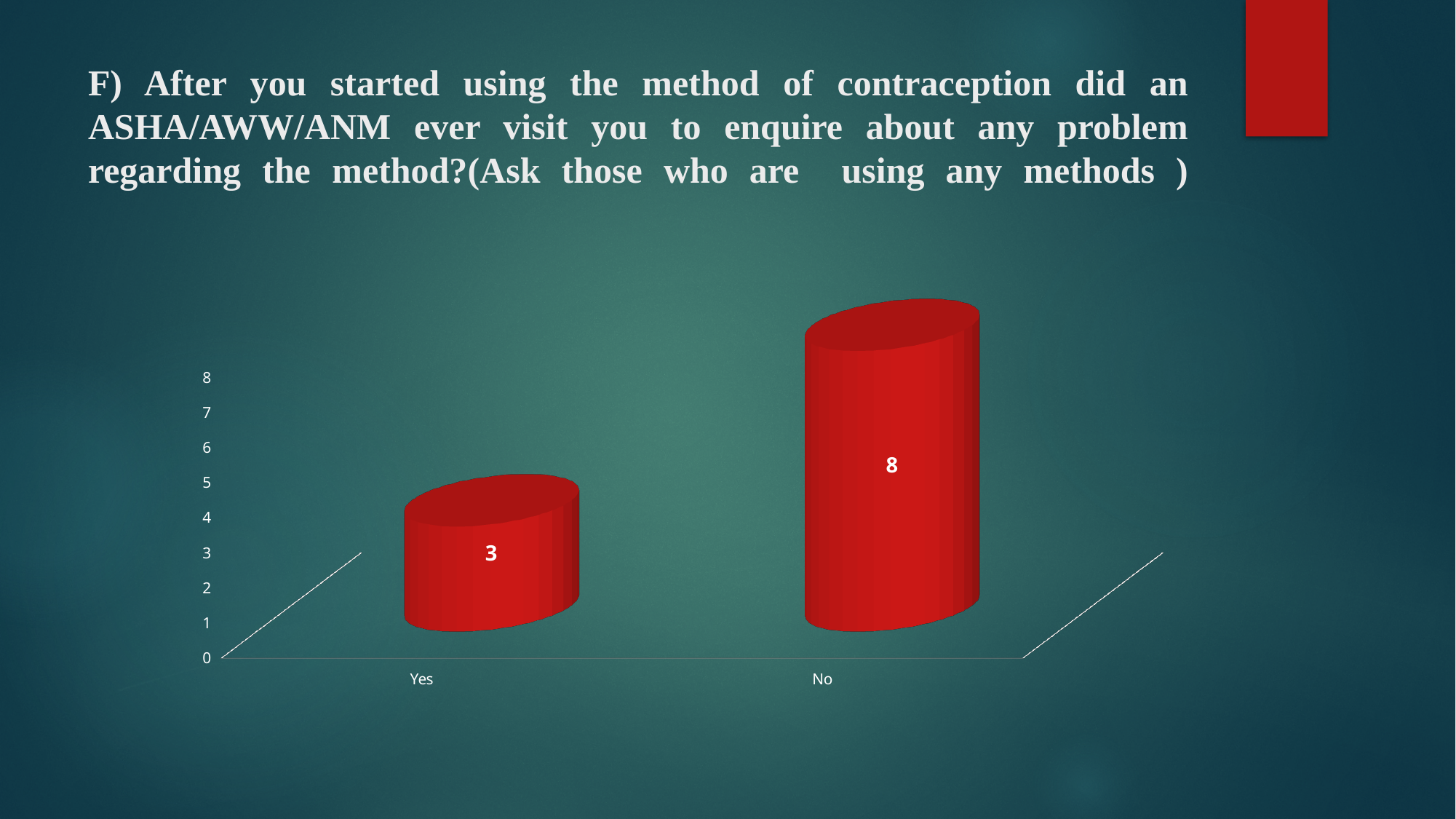
How many categories are shown on the x axis? 2 Which category has the highest value? No What is the total of the two values shown in the chart? 11 Is the value for "Yes" greater or less than 5? less Which is larger, the value for "Yes" or the value for "No"? No What kind of chart is shown on the slide? bar chart What colour are the bars in the chart? red Is the value for "No" greater or less than 6? greater What is the value for "No"? 8 Which category has the lowest value? Yes What is the value for "Yes"? 3 What is the difference between the values for "No" and "Yes"? 5